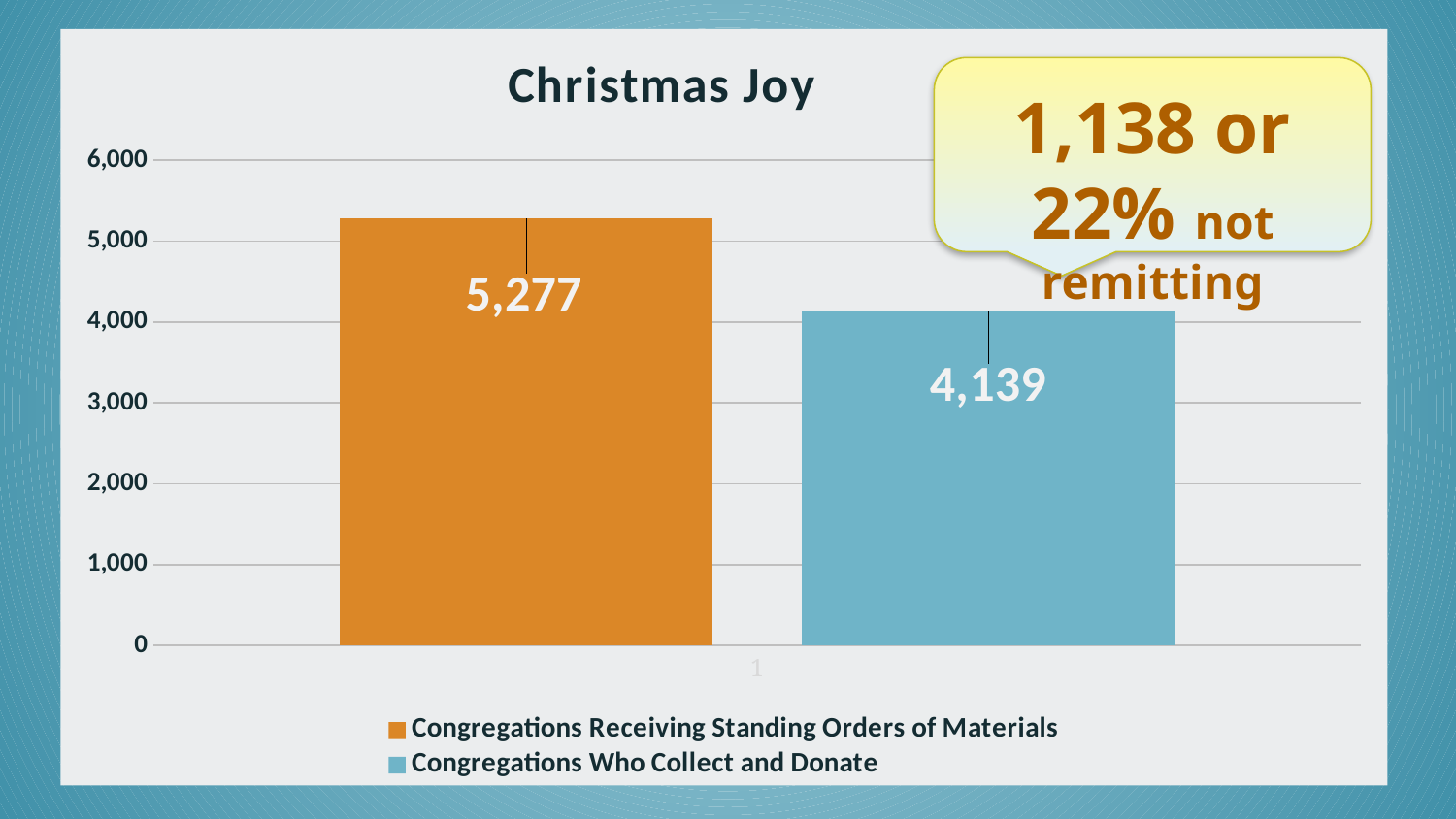
What kind of chart is shown on the slide? bar chart What is the value for Congregations Receiving Standing Orders of Materials? 5,277 Which series has the higher value? Congregations Receiving Standing Orders of Materials Which series has the lower value? Congregations Who Collect and Donate What is the value for Congregations Who Collect and Donate? 4,139 Is the value for Congregations Receiving Standing Orders of Materials greater or less than 5,000? greater Is the value for Congregations Receiving Standing Orders of Materials larger or smaller than the value for Congregations Who Collect and Donate? larger How many series does the legend list? 2 What is the difference between Congregations Receiving Standing Orders of Materials and Congregations Who Collect and Donate? 1,138 Is the value for Congregations Who Collect and Donate greater or less than 5,000? less What colour is the bar for Congregations Who Collect and Donate? blue What is the title of the chart? Christmas Joy